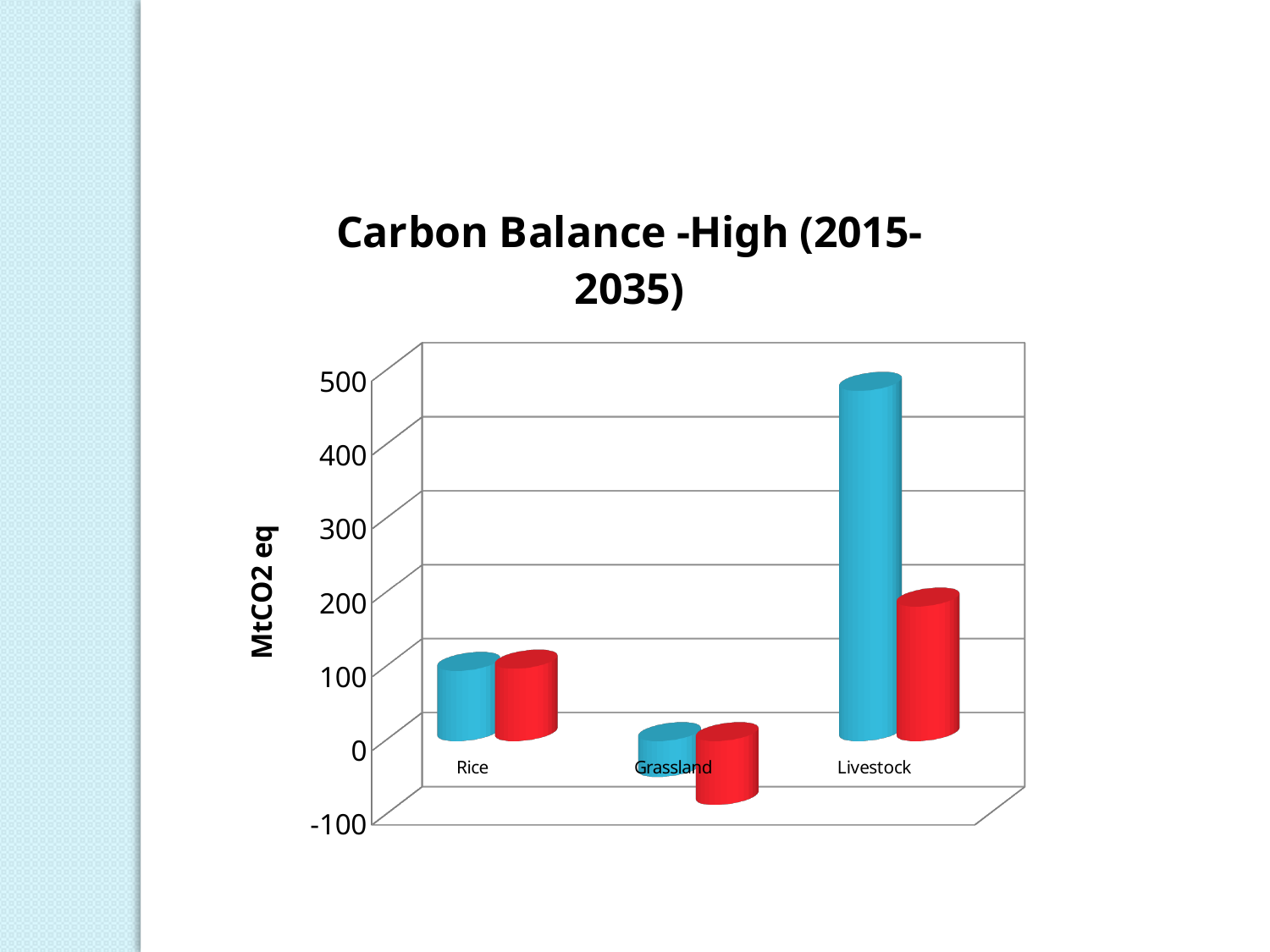
Is the value of the red bar for Livestock greater or less than 300? less For Livestock, which bar is larger, the blue bar or the red bar? the blue bar What kind of chart is shown on the slide? bar chart How many categories are shown on the x axis of the chart? 3 Which category has the lowest blue bar? Grassland What is the title of the chart? Carbon Balance -High (2015-2035) What is the label on the vertical axis of the chart? MtCO2 eq Is the value of the blue bar for Rice greater or less than 200? less Which category has the tallest blue bar? Livestock Which category has the lowest red bar? Grassland Is the value of the red bar for Grassland greater or less than 0? less